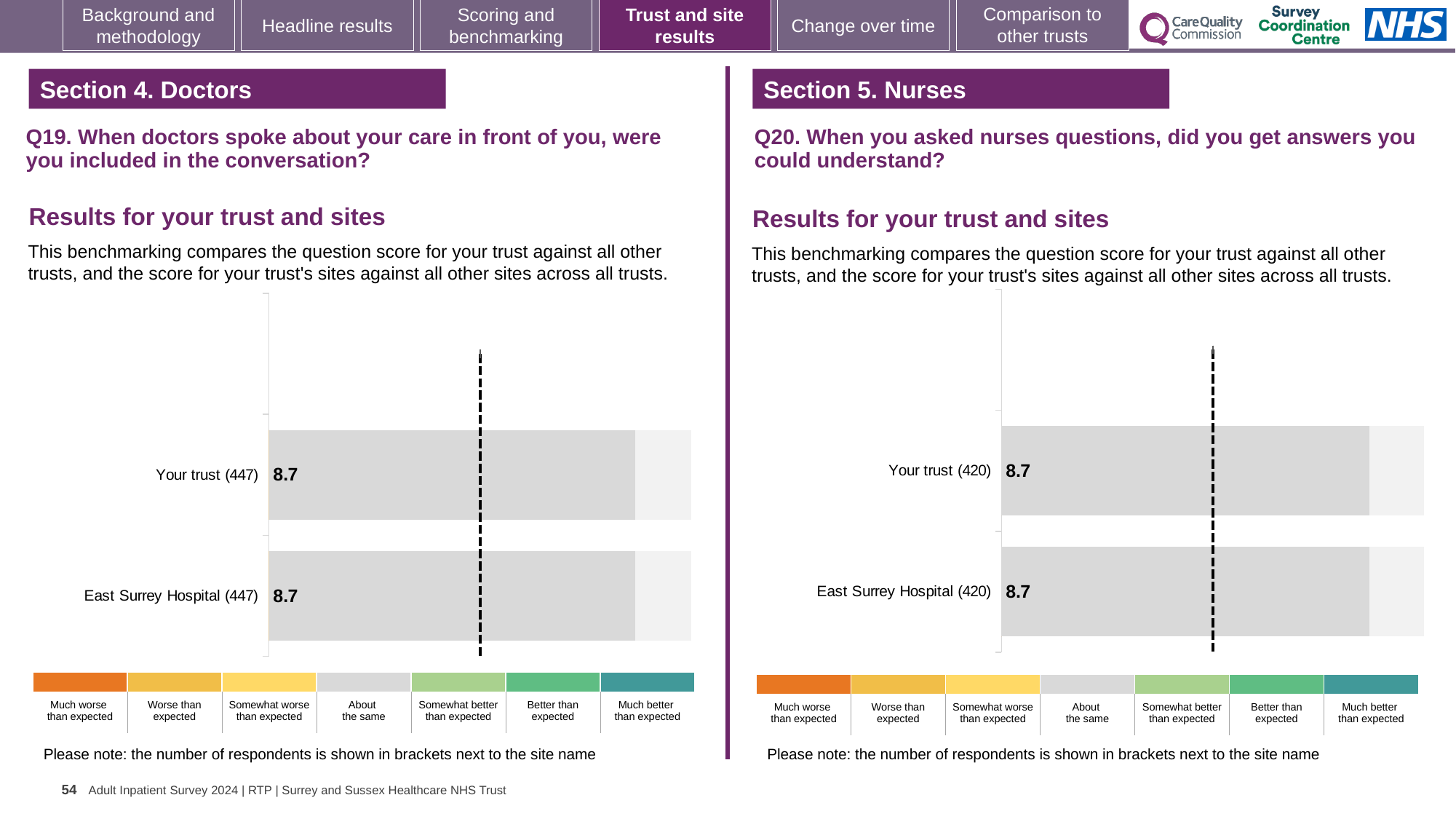
On the left chart (Q19, doctors), what is the score for East Surrey Hospital? 8.7 On the left chart (Q19, doctors), how many respondents are shown in brackets for East Surrey Hospital? 447 On the right chart (Q20, nurses), what is the score for East Surrey Hospital? 8.7 On the right chart (Q20, nurses), how many bars are plotted? 2 On the left chart (Q19, doctors), how many bars are plotted? 2 On the right chart (Q20, nurses), how many respondents are shown in brackets for Your trust? 420 What kind of chart is used on the left (Q19, doctors)? Bar chart On the left chart (Q19, doctors), what is the score for Your trust? 8.7 On the left chart (Q19, doctors), which category in the colour key is shown in dark orange? Much worse than expected On the left chart (Q19, doctors), what is the difference between the Your trust score and the East Surrey Hospital score? 0 On the right chart (Q20, nurses), how many categories does the colour key below the chart list? 7 On the right chart (Q20, nurses), what is the score for Your trust? 8.7